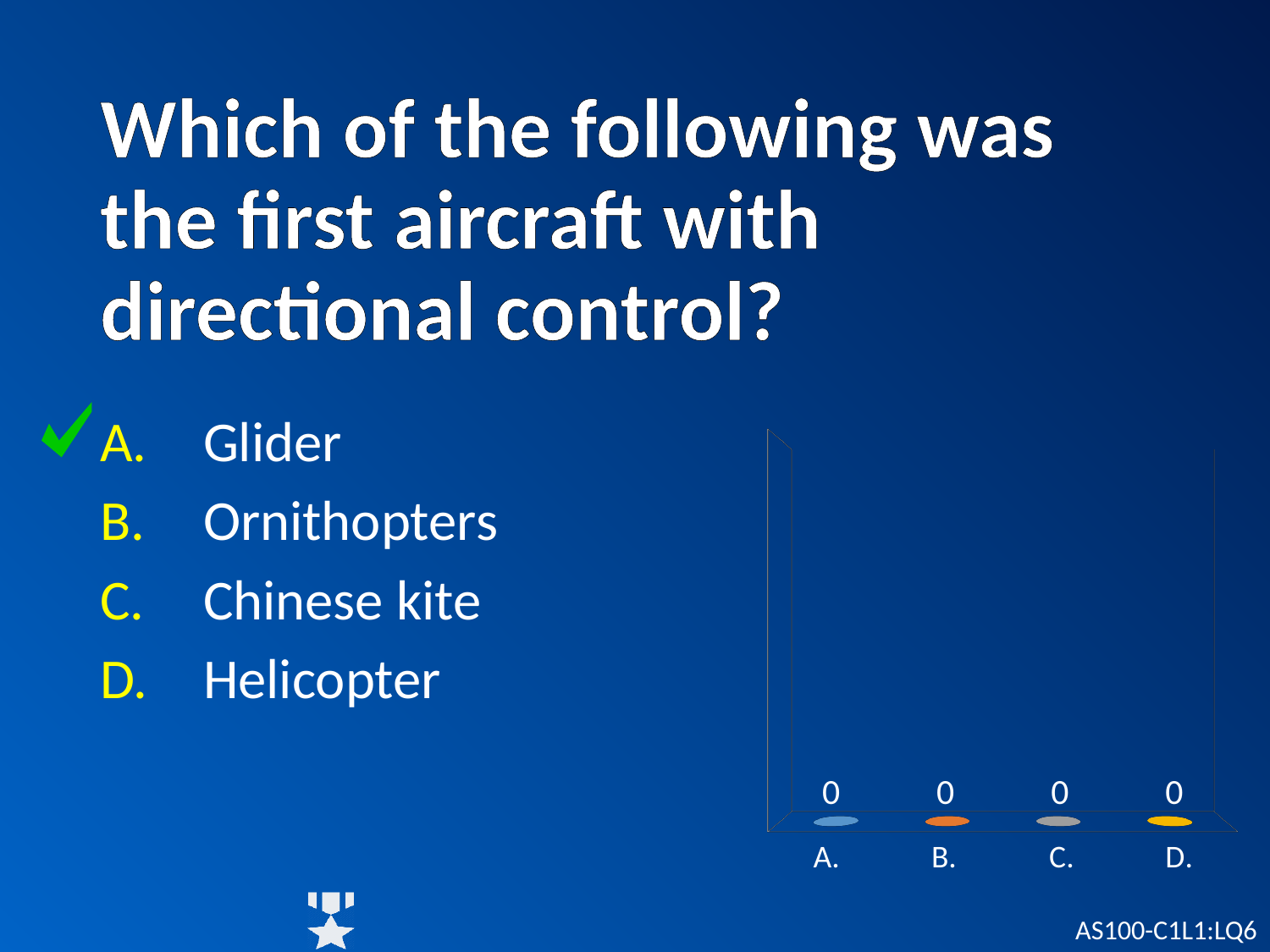
What is the difference between the values for A. and D. in the chart? 0 Do the values in the chart rise, fall, or stay the same from A. to D.? stay the same How many categories are plotted on the chart's x axis? 4 What colour is the bar for category B. in the chart? orange What kind of chart is shown on the slide? bar chart What is the total of the values for A., B., C. and D. in the chart? 0 What are the category labels along the x axis of the chart? A., B., C., D. What is the value shown for category D. in the chart? 0 What is the value shown for category B. in the chart? 0 What is the value shown for category A. in the chart? 0 What is the value shown for category C. in the chart? 0